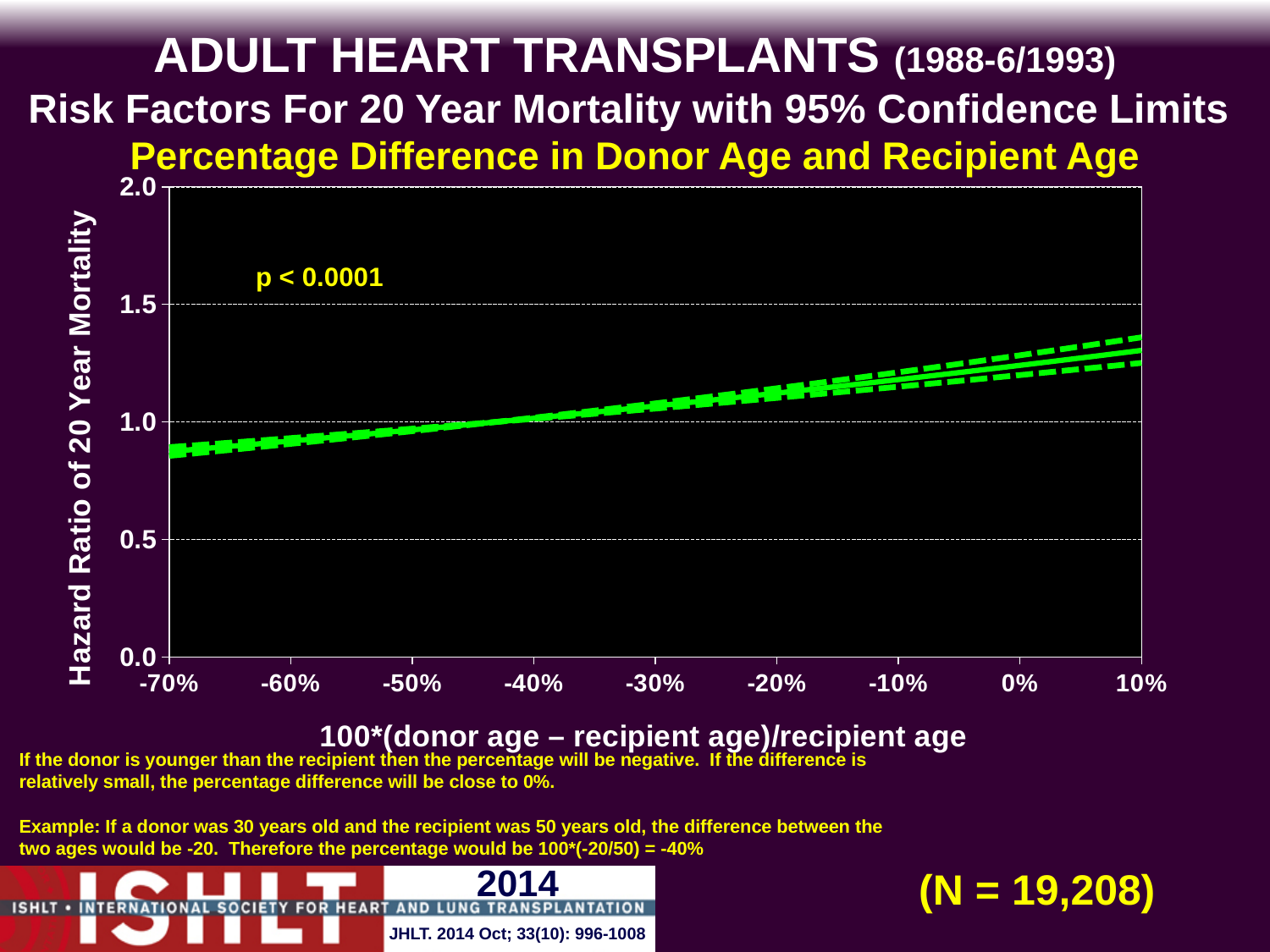
Is the hazard ratio at a percentage difference of -60% greater or less than 1.0? less Which has the higher hazard ratio: a percentage difference of -70% or 10%? 10% What kind of chart is shown on the slide? line chart How many tick labels are shown on the x-axis? 9 Is the hazard ratio at a percentage difference of 0% greater or less than 1.0? greater Is the hazard ratio at a percentage difference of 10% greater or less than 1.0? greater What is the p-value shown on the chart? p < 0.0001 Does the hazard ratio rise or fall as the percentage difference in donor age and recipient age increases from -70% to 10%? rise What is the label of the y-axis? Hazard Ratio of 20 Year Mortality What is the highest value shown on the y-axis? 2.0